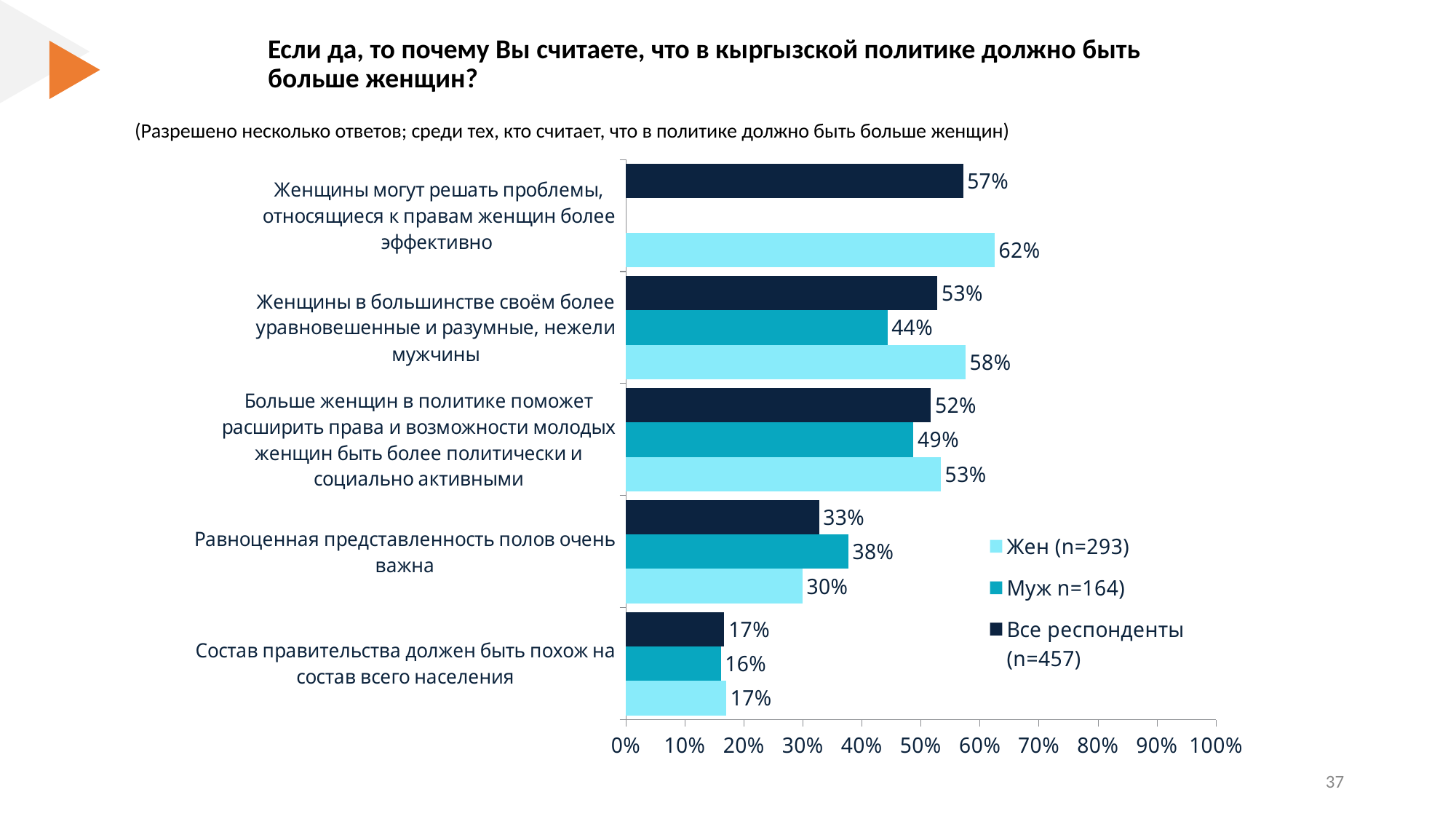
How many response categories are shown on the chart? 5 What is the value for Муж (n=164) for 'Равноценная представленность полов очень важна'? 38% What type of chart is shown on the slide? bar chart What is the value for Муж (n=164) for 'Состав правительства должен быть похож на состав всего населения'? 16% What is the value for Все респонденты (n=457) for 'Женщины в большинстве своём более уравновешенные и разумные, нежели мужчины'? 53% For 'Равноценная представленность полов очень важна', which is larger: the value for Муж (n=164) or for Жен (n=293)? Муж (n=164) How many series does the legend list? 3 What is the value for Все респонденты (n=457) for 'Больше женщин в политике поможет расширить права и возможности молодых женщин быть более политически и социально активными'? 52% Which category has the lowest value for Все респонденты (n=457)? Состав правительства должен быть похож на состав всего населения What is the difference between the Жен (n=293) and Муж (n=164) values for 'Женщины в большинстве своём более уравновешенные и разумные, нежели мужчины'? 14% Which category has the highest value for Жен (n=293)? Женщины могут решать проблемы, относящиеся к правам женщин более эффективно What is the value for Жен (n=293) for 'Женщины могут решать проблемы, относящиеся к правам женщин более эффективно'? 62%